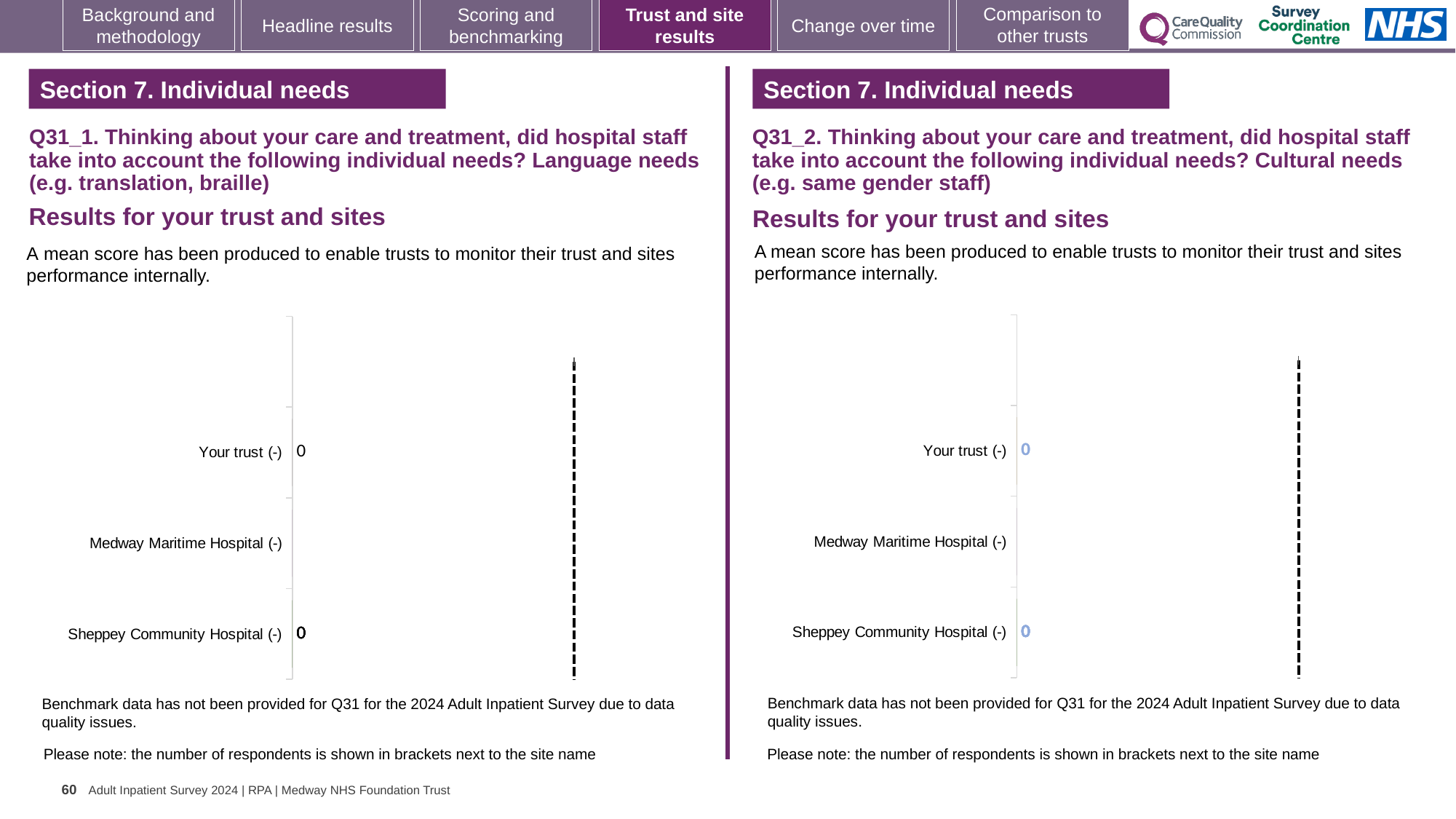
What kind of chart is the right chart (Q31_2, Cultural needs)? bar chart On the right chart (Q31_2, Cultural needs), what is the value shown for Your trust? 0 On the left chart (Q31_1, Language needs), which category is listed first at the top of the axis? Your trust (-) On the right chart (Q31_2, Cultural needs), how many categories are listed on the vertical axis? 3 On the right chart (Q31_2, Cultural needs), what is the value shown for Sheppey Community Hospital? 0 On the right chart (Q31_2, Cultural needs), which category is listed last at the bottom of the axis? Sheppey Community Hospital (-) On the left chart (Q31_1, Language needs), how many categories are listed on the vertical axis? 3 On the left chart (Q31_1, Language needs), what is the value shown for Sheppey Community Hospital? 0 On the left chart (Q31_1, Language needs), what is the value shown for Your trust? 0 What kind of chart is the left chart (Q31_1, Language needs)? bar chart